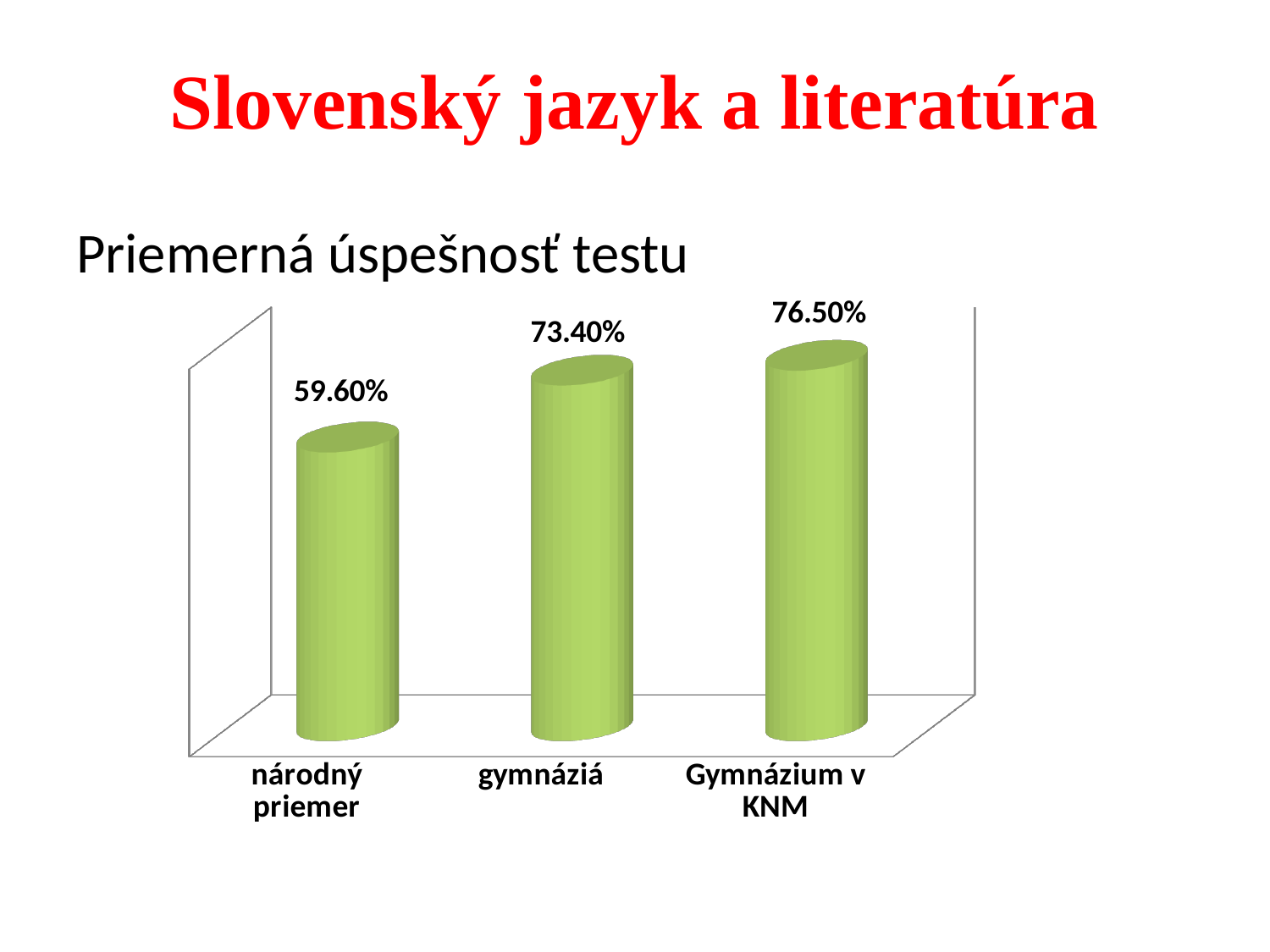
What kind of chart is shown on the slide? bar chart What is the value for Gymnázium v KNM? 76.50% What is the value for gymnáziá? 73.40% Which category has the lowest value? národný priemer What is the title of the chart? Priemerná úspešnosť testu How many categories are shown in the chart? 3 What is the difference between the values for gymnáziá and národný priemer? 13.80% Which category has the highest value? Gymnázium v KNM Do the values rise or fall from left to right across the categories? rise What is the difference between the values for Gymnázium v KNM and národný priemer? 16.90% What is the value for národný priemer? 59.60% Which is larger, the value for gymnáziá or the value for Gymnázium v KNM? Gymnázium v KNM